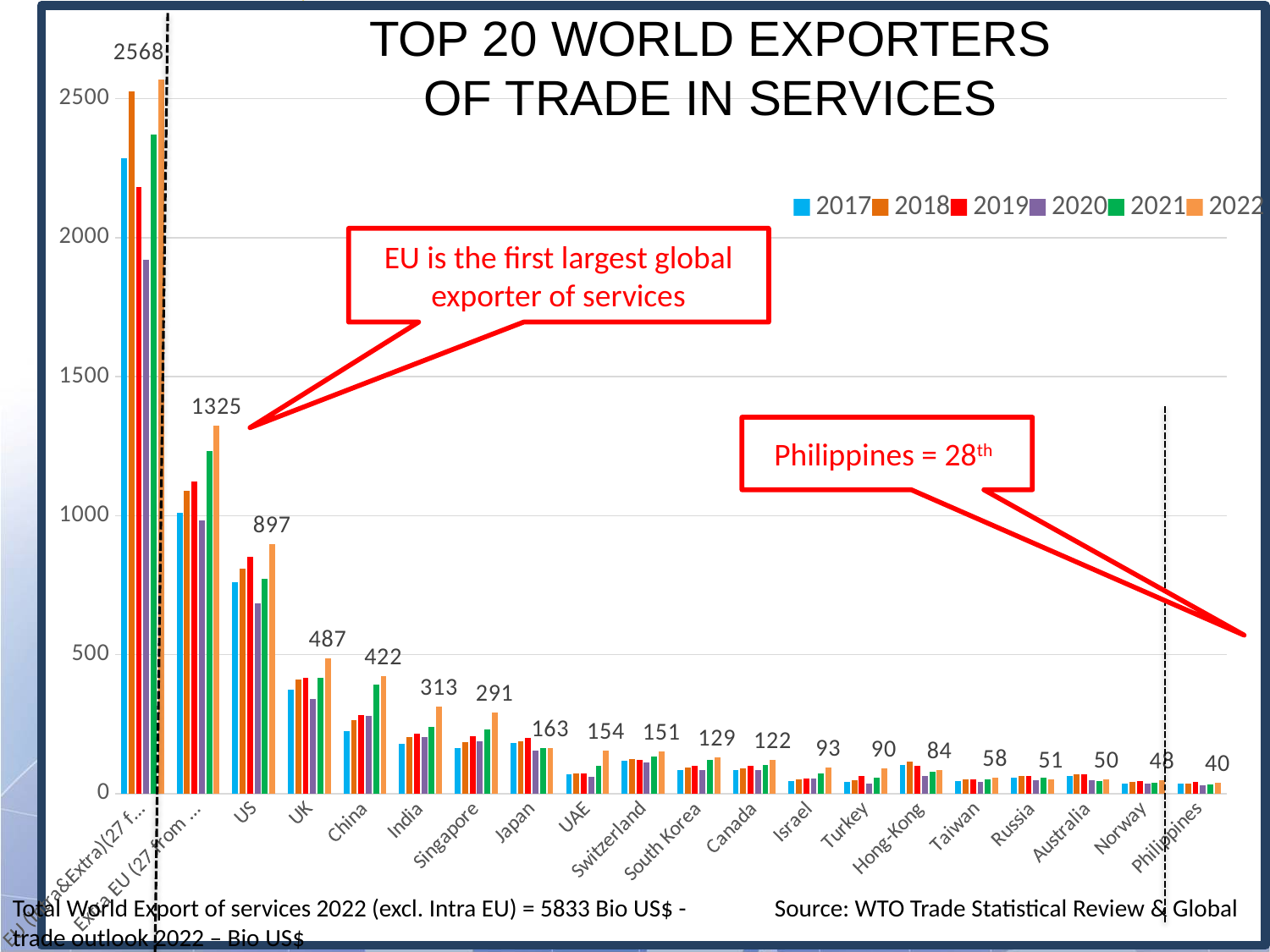
What kind of chart is shown on the slide? bar chart What is the difference between the labelled 2022 values for the US and the UK? 410 Is the 2017 value for the US greater or less than 500? greater Which has the larger labelled 2022 value, China or India? China Which category has the lowest labelled value on the chart? Philippines Which category has the highest labelled value on the chart? EU (Intra&Extra) Do the labelled values generally rise or fall moving from left to right along the x axis? fall What is the labelled 2022 value for Singapore? 291 How many series does the legend list? 6 How many countries or regions are shown along the x axis? 20 What is the labelled 2022 value for the Philippines? 40 What is the labelled 2022 value for the US? 897